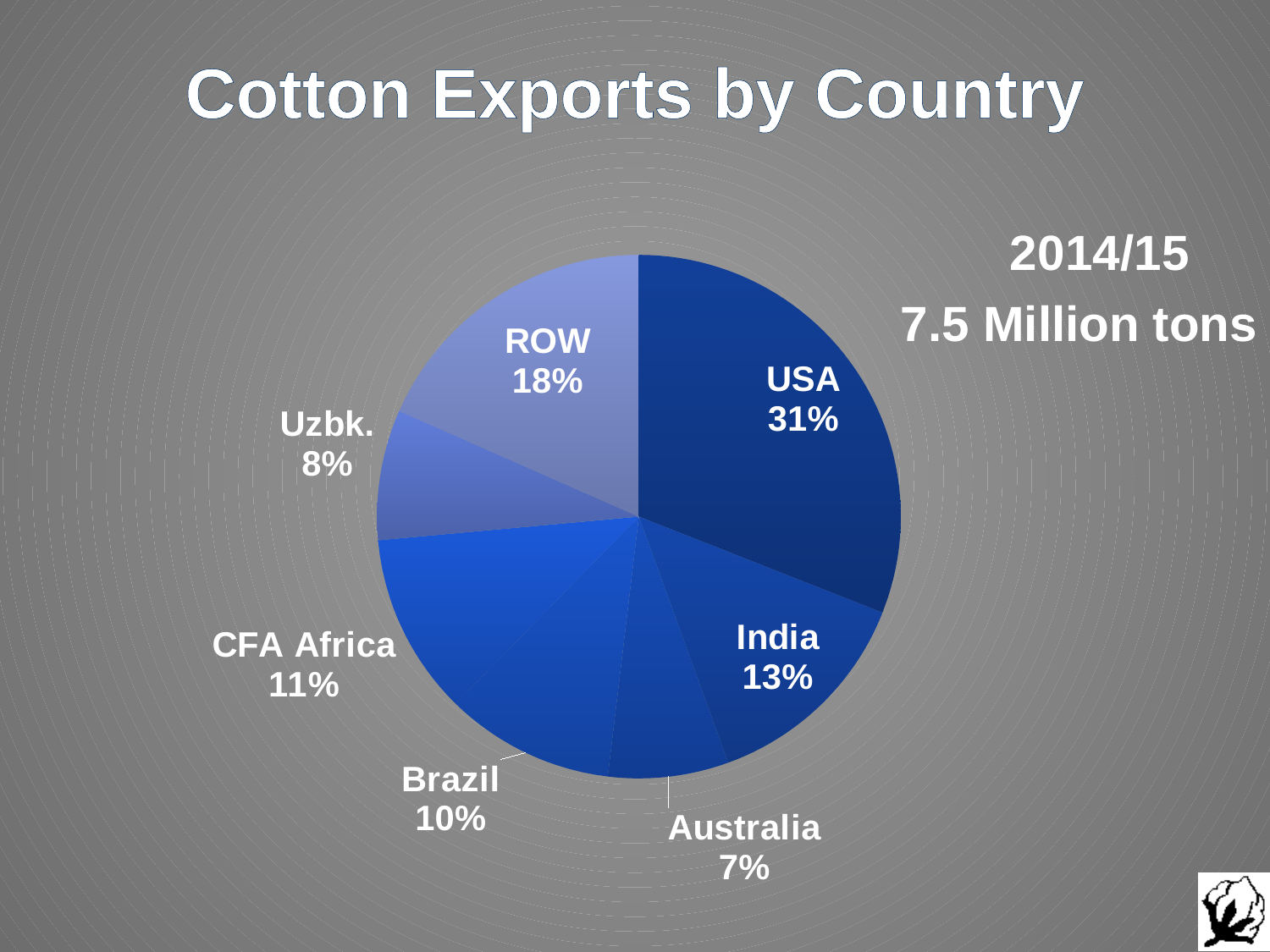
Which labelled slice has the smallest share of cotton exports? Australia How many slices does the pie chart have? 7 What is the title of the chart? Cotton Exports by Country What share of cotton exports does CFA Africa account for? 11% Which has a larger share of cotton exports, Uzbk. or Brazil? Brazil What share of cotton exports does the USA account for? 31% Which country has the largest share of cotton exports? USA What is the difference in share between the USA and India? 18% What share of cotton exports does India account for? 13% What share of cotton exports does Brazil account for? 10% What kind of chart is shown on the slide? Pie chart What total volume of cotton exports does the slide state for 2014/15? 7.5 Million tons